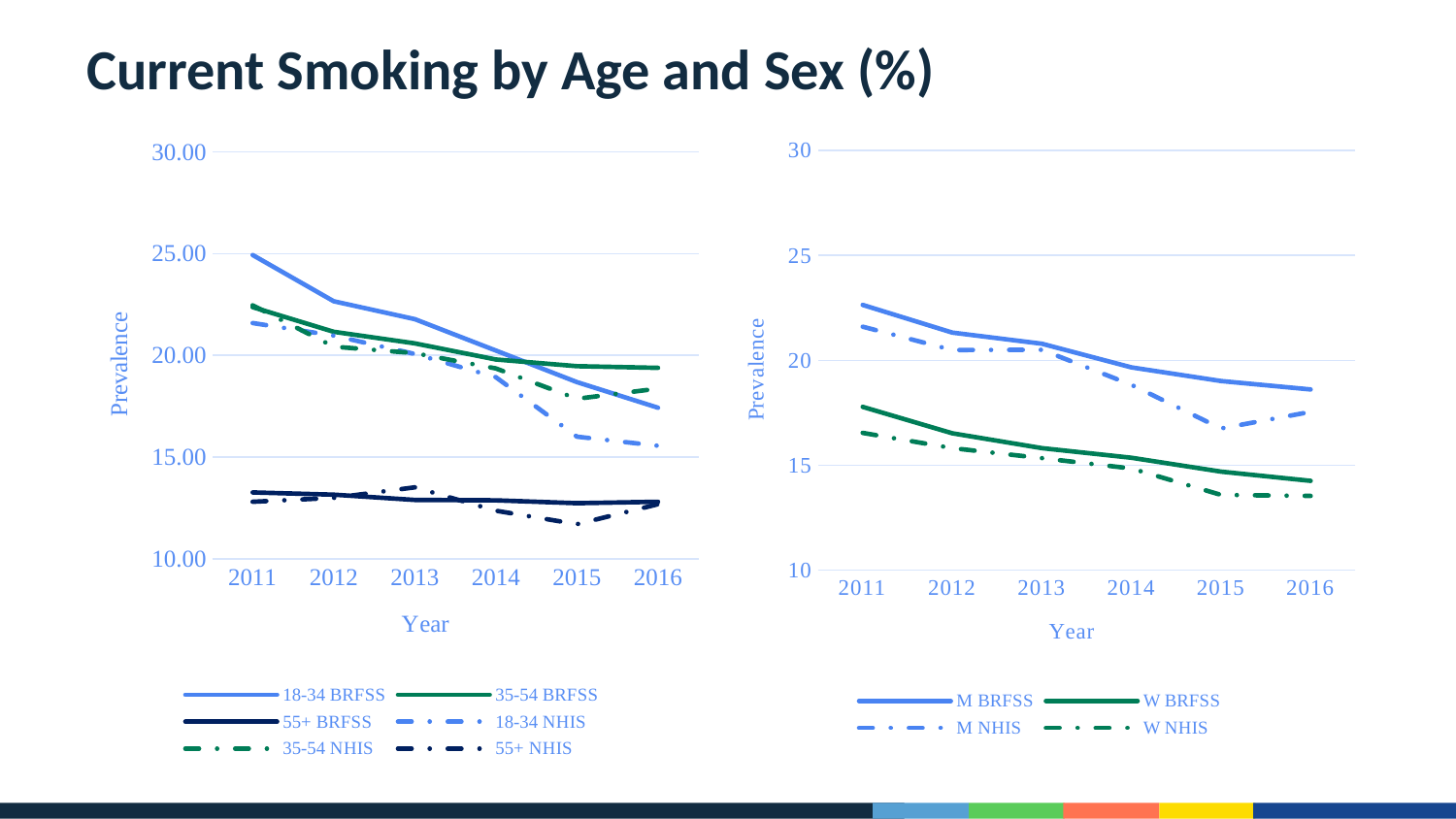
In the right chart, does the W BRFSS line rise or fall from 2011 to 2016? fall In the left chart, does the 18-34 BRFSS line rise or fall from 2011 to 2016? fall How many series does the legend of the left chart list? 6 What kind of chart is the left chart on the slide? line chart In the right chart, which is larger in 2016: M BRFSS or W BRFSS? M BRFSS How many series does the legend of the right chart list? 4 In the left chart, which is larger in 2011: 18-34 BRFSS or 55+ BRFSS? 18-34 BRFSS How many years are shown on the x axis of the right chart? 6 In the left chart, is the value for 55+ BRFSS in 2016 greater or less than 15? less In the right chart, is the value for W NHIS in 2016 greater or less than 15? less In the left chart, is the value for 18-34 BRFSS in 2011 greater or less than 20? greater